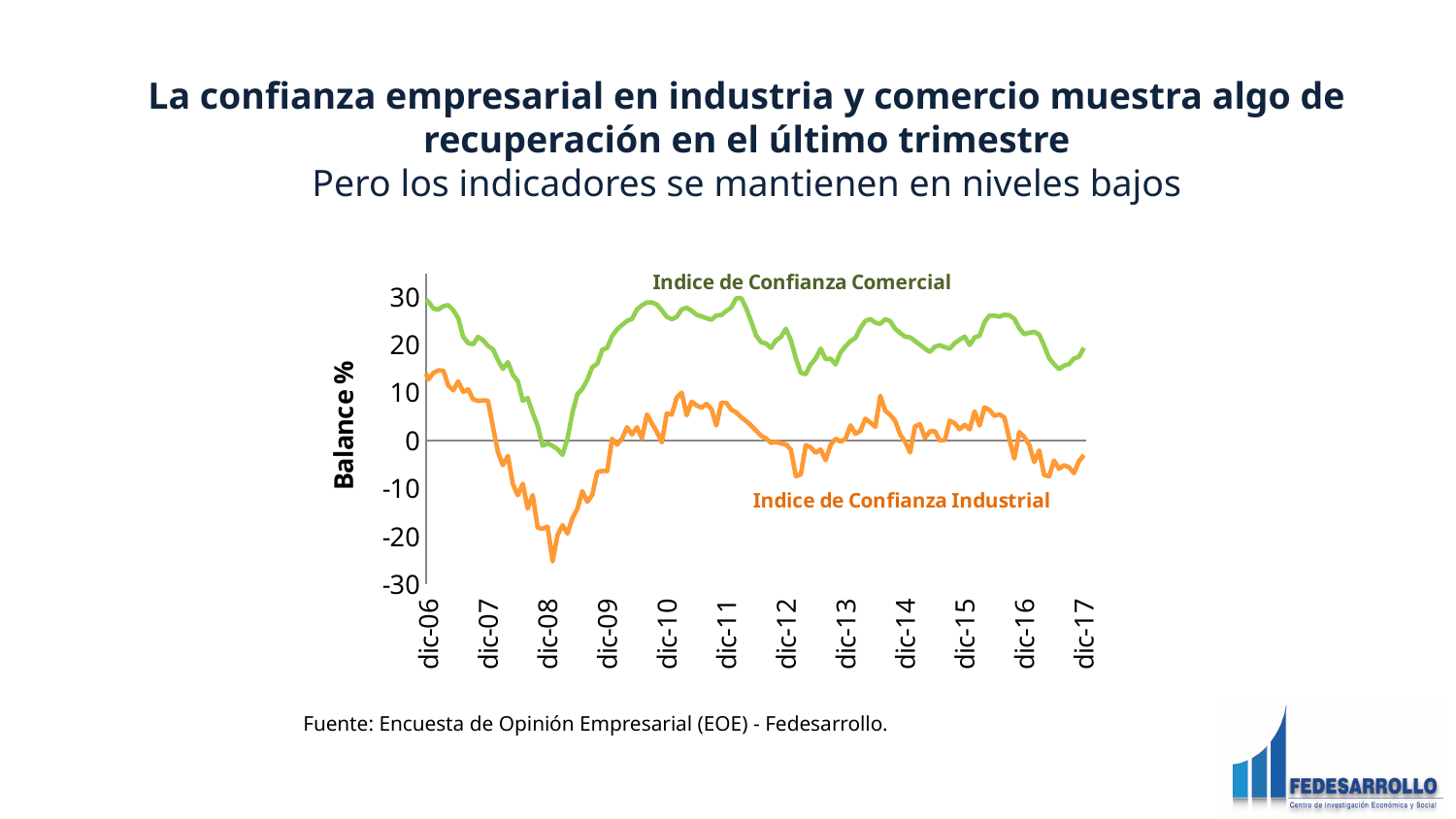
Is the value of Indice de Confianza Comercial at dic-17 greater or less than 10? greater Is the value of Indice de Confianza Industrial at dic-08 greater or less than -10? less Is the value of Indice de Confianza Comercial at dic-06 greater or less than 20? greater What type of chart is shown on the slide? line chart Around which x-axis label does Indice de Confianza Industrial reach its lowest value? dic-08 At dic-06, which series has the higher value, Indice de Confianza Comercial or Indice de Confianza Industrial? Indice de Confianza Comercial How many series are plotted in the chart? 2 What is the label on the vertical axis of the chart? Balance % Which series is drawn in orange? Indice de Confianza Industrial Does Indice de Confianza Industrial rise or fall between dic-06 and dic-08? fall